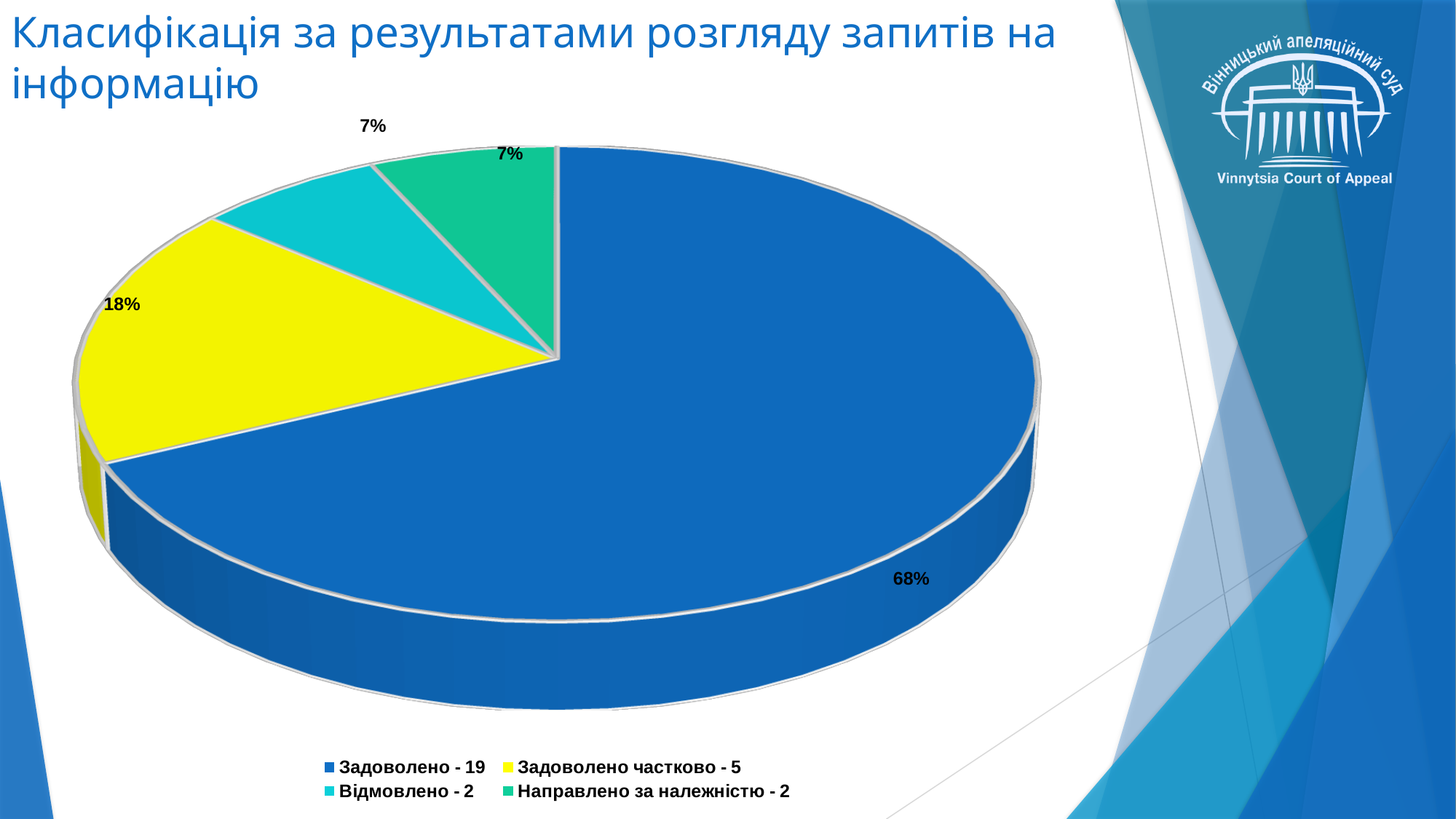
Which category has the largest slice of the pie? Задоволено - 19 What share of the pie does the "Задоволено частково - 5" slice represent? 18% What share of the pie does the "Відмовлено - 2" slice represent? 7% What share of the pie does the "Задоволено - 19" slice represent? 68% How many slices does the pie chart have? 4 What colour is the "Задоволено частково - 5" slice? yellow What is the difference in percentage points between the "Задоволено - 19" slice and the "Задоволено частково - 5" slice? 50 What is the title of the slide containing the chart? Класифікація за результатами розгляду запитів на інформацію What kind of chart is shown on the slide? pie chart Which is larger: the share for "Задоволено частково - 5" or the share for "Відмовлено - 2"? Задоволено частково - 5 How many entries does the legend list? 4